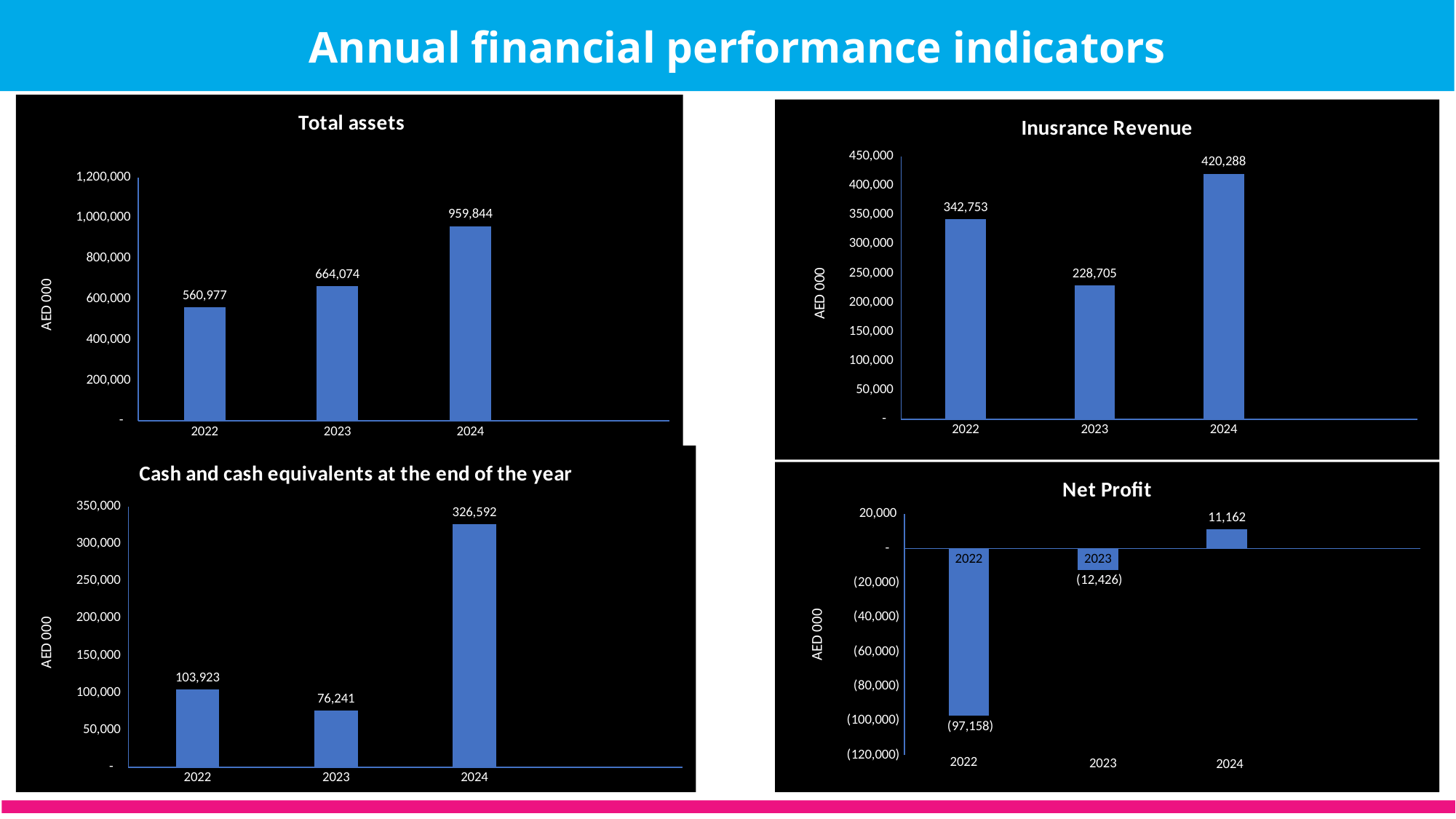
In the Inusrance Revenue chart, which is larger, the value for 2022 or the value for 2023? 2022 In the Total assets chart, what is the difference between the 2024 and 2023 values? 295,770 In the Cash and cash equivalents at the end of the year chart, what is the difference between the 2024 and 2022 values? 222,669 In the Inusrance Revenue chart, which year has the highest value? 2024 In the Net Profit chart, which year has the highest value? 2024 In the Cash and cash equivalents at the end of the year chart, what is the value for 2022? 103,923 In the Total assets chart, do the values rise or fall from 2022 to 2024? rise In the Total assets chart, what is the value for 2024? 959,844 In the Total assets chart, which year has the lowest value? 2022 How many charts are on the slide, and what type are they? 4 bar charts In the Inusrance Revenue chart, what is the value for 2023? 228,705 In the Net Profit chart, what is the value for 2022? (97,158)